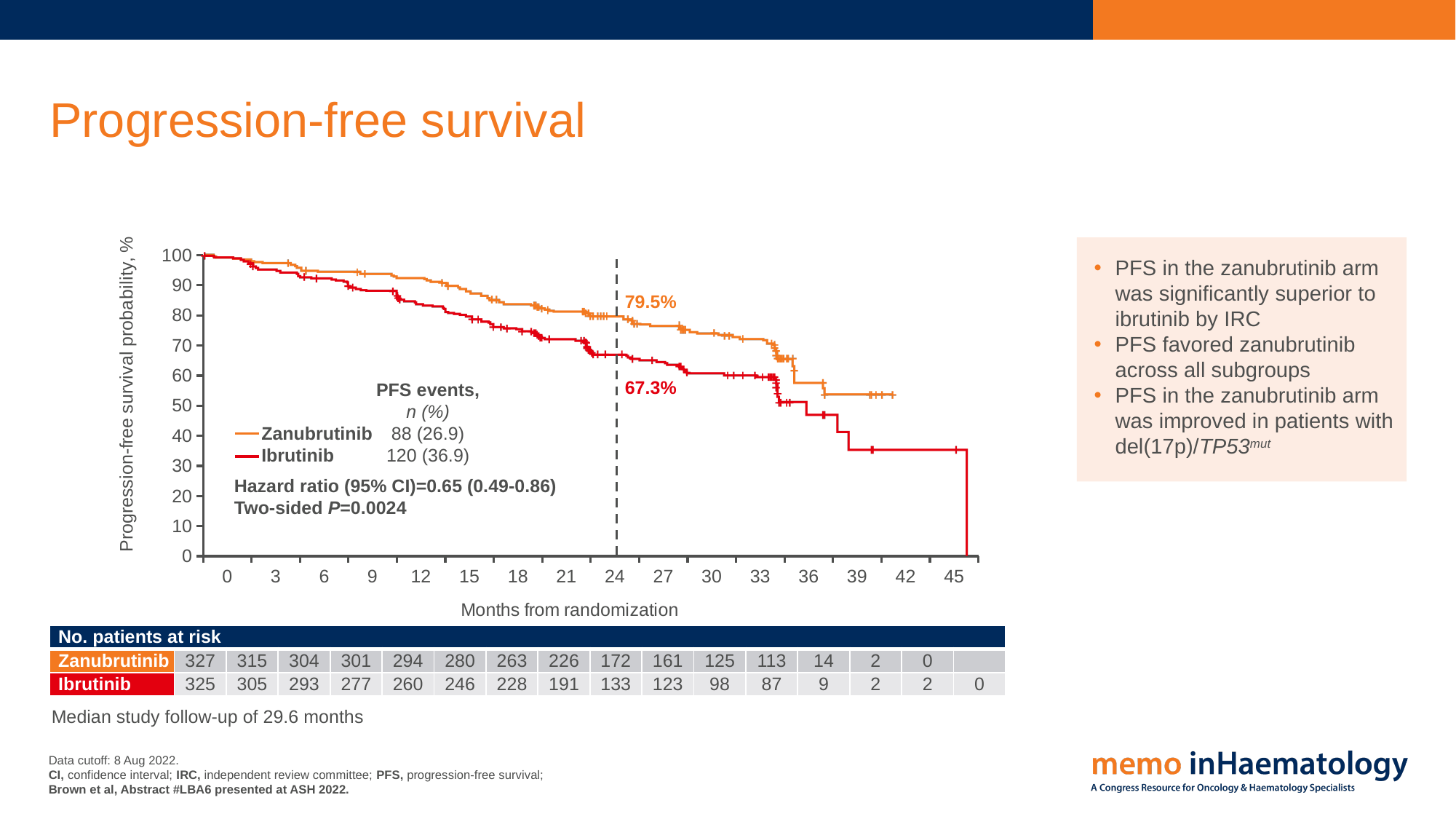
How many treatment arms (series) does the chart legend list? 2 What is the hazard ratio (95% CI) shown on the chart? 0.65 (0.49-0.86) Is the PFS probability for ibrutinib at 12 months greater or less than 70? greater What is the progression-free survival probability for ibrutinib at 24 months, as labelled on the chart? 67.3% What kind of chart is shown on the slide? Line chart (Kaplan-Meier survival curve) How many PFS events, n (%), are reported for the ibrutinib arm? 120 (36.9) Which arm has the higher labelled PFS probability at 24 months, zanubrutinib or ibrutinib? Zanubrutinib What is the difference between the labelled 24-month PFS probabilities for zanubrutinib and ibrutinib? 12.2 percentage points What is the label of the x axis? Months from randomization What is the progression-free survival probability for zanubrutinib at 24 months, as labelled on the chart? 79.5% Do the survival curves rise or fall as months from randomization increase? Fall According to the number of patients at risk table, how many zanubrutinib patients were at risk at month 0? 327